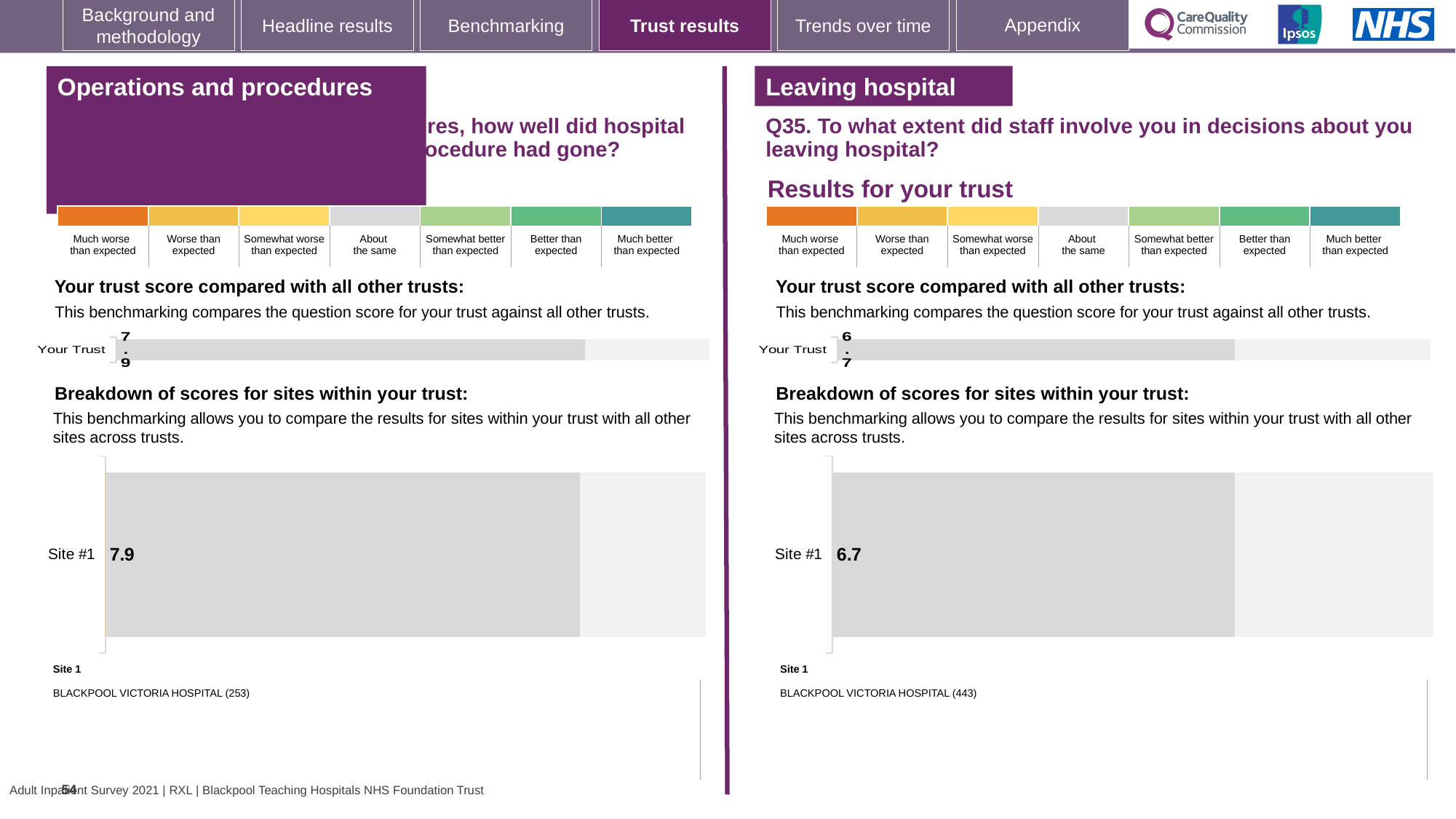
On the 'Operations and procedures' section, what is the score shown for Your Trust in the 'Your trust score compared with all other trusts' chart? 7.9 On the 'Leaving hospital' section, what is the score shown for Your Trust in the 'Your trust score compared with all other trusts' chart? 6.7 In the 'Breakdown of scores for sites within your trust' chart on the right (Leaving hospital), what is the score for Site #1? 6.7 What is the difference between the Your Trust score on the Operations and procedures side and the Your Trust score on the Leaving hospital side? 1.2 What type of chart is used to show the Site #1 score in the Leaving hospital breakdown section? Bar chart Is the Site #1 score in the Leaving hospital breakdown chart greater or less than 7? less Which is larger: the Site #1 score in the Operations and procedures breakdown chart or the Site #1 score in the Leaving hospital breakdown chart? Operations and procedures (7.9) Which hospital is listed as Site 1 beneath the breakdown chart on the Operations and procedures side? BLACKPOOL VICTORIA HOSPITAL (253) Which hospital is listed as Site 1 beneath the breakdown chart on the Leaving hospital side? BLACKPOOL VICTORIA HOSPITAL (443) How many sites are shown in the 'Breakdown of scores for sites within your trust' chart on the Operations and procedures side? 1 How many sites are shown in the 'Breakdown of scores for sites within your trust' chart on the Leaving hospital side? 1 In the 'Breakdown of scores for sites within your trust' chart on the left (Operations and procedures), what is the score for Site #1? 7.9